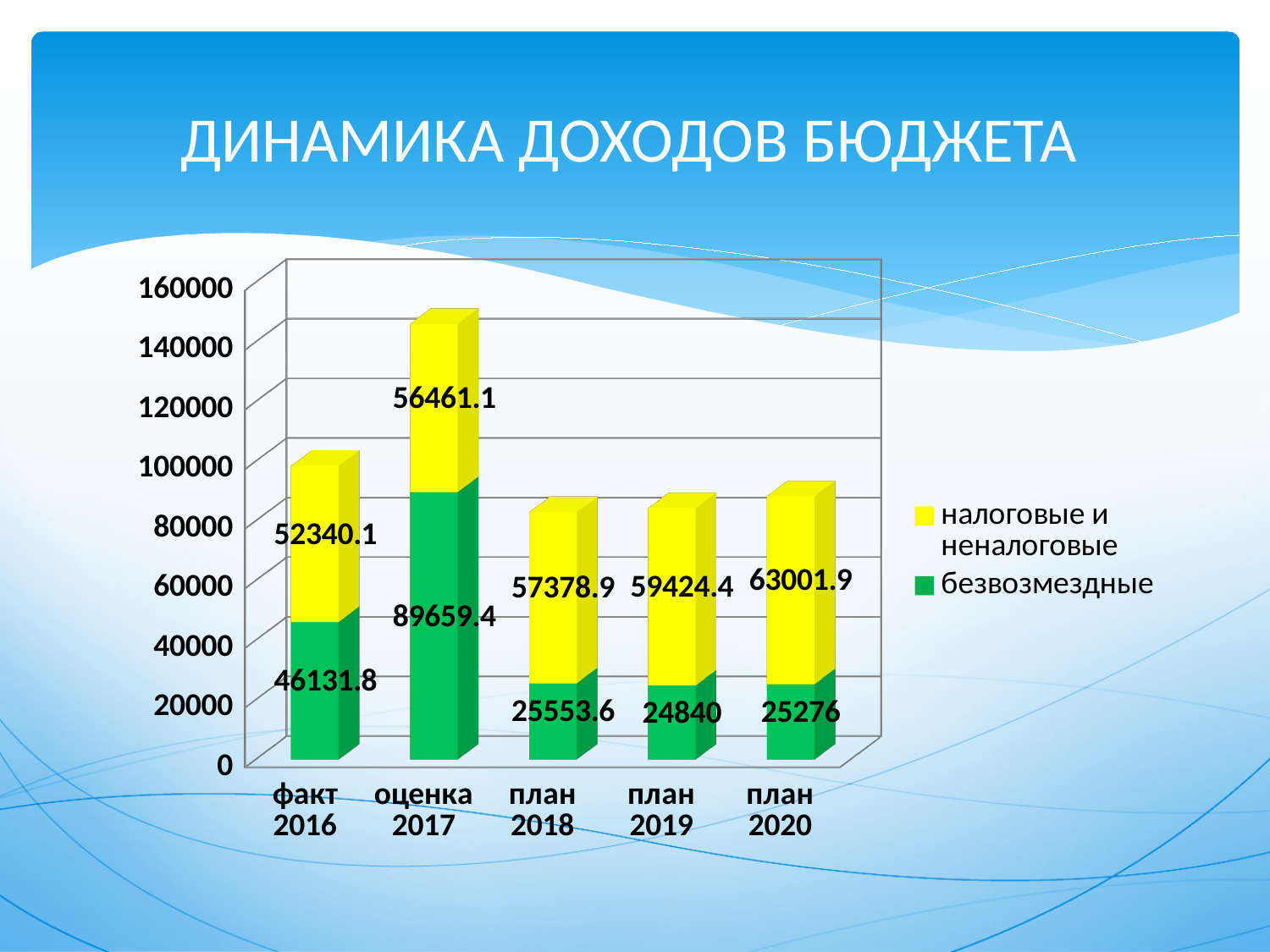
What is the total of the stacked bar for план 2018? 82932.5 How many categories are shown on the x axis? 5 What is the value of налоговые и неналоговые for план 2020? 63001.9 Which category has the highest value for безвозмездные? оценка 2017 Which is larger: безвозмездные for факт 2016 or безвозмездные for план 2018? факт 2016 What kind of chart is shown on the slide? stacked bar chart What is the difference between the налоговые и неналоговые values for план 2020 and план 2019? 3577.5 Which category has the lowest value for налоговые и неналоговые? факт 2016 What is the value of безвозмездные for план 2019? 24840 How many series does the legend list? 2 What is the total of the stacked bar for оценка 2017? 146120.5 What is the value of безвозмездные for оценка 2017? 89659.4